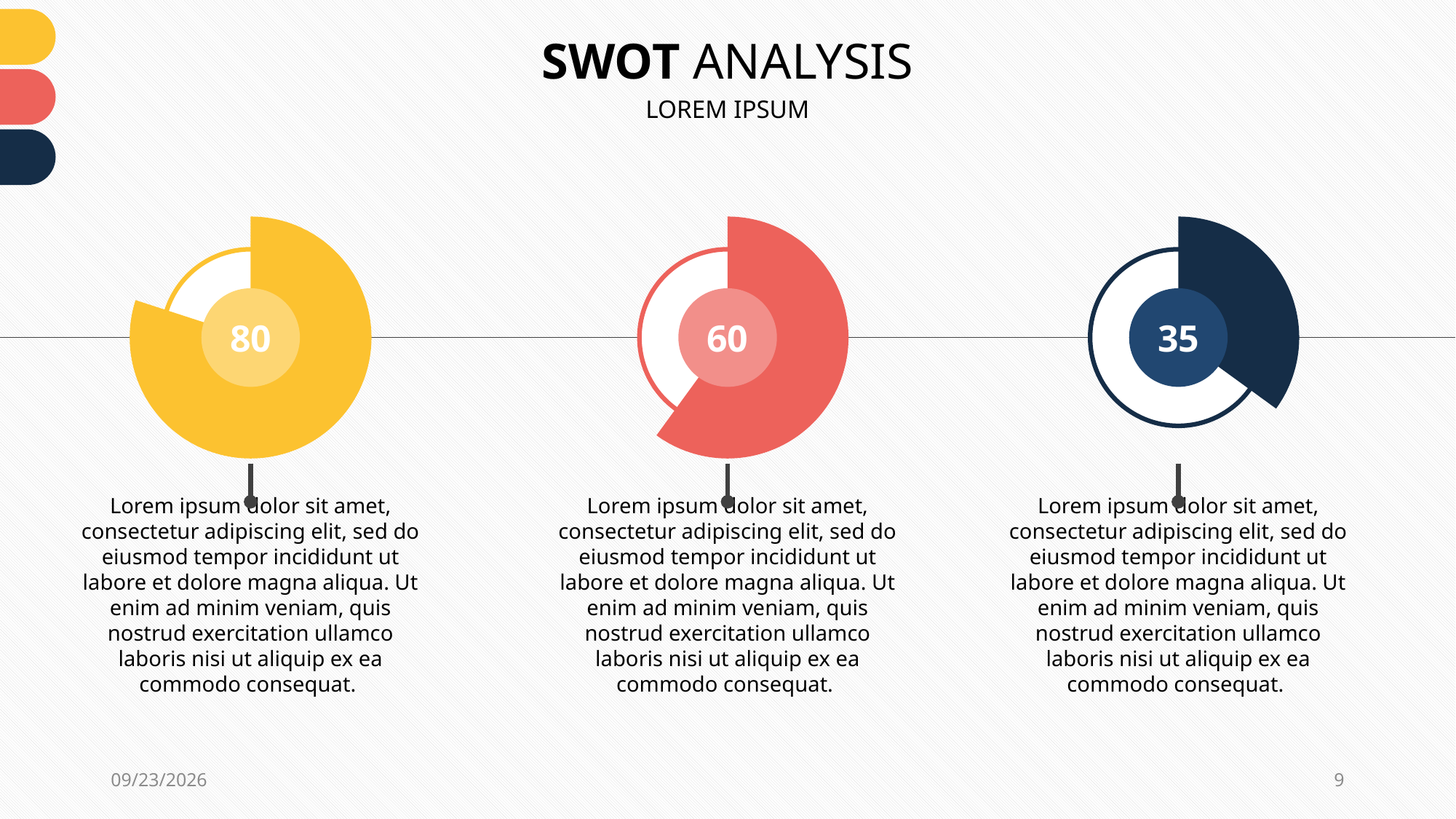
What is the title of the slide containing the three charts? SWOT ANALYSIS What kind of chart is used for each of the three figures on the slide? Pie chart What value is shown in the centre of the right (dark blue) chart? 35 How many charts are shown on the slide? 3 What colour is the filled slice of the chart showing the value 60? Red What value is shown in the centre of the left (yellow) chart? 80 Which of the three charts shows the lowest value? The right (dark blue) chart, 35 Which is larger, the value on the middle (red) chart or the value on the right (dark blue) chart? The middle (red) chart, 60 What is the difference between the value on the left (yellow) chart and the value on the middle (red) chart? 20 What value is shown in the centre of the middle (red) chart? 60 What is the difference between the value on the left (yellow) chart and the value on the right (dark blue) chart? 45 Which of the three charts shows the highest value? The left (yellow) chart, 80